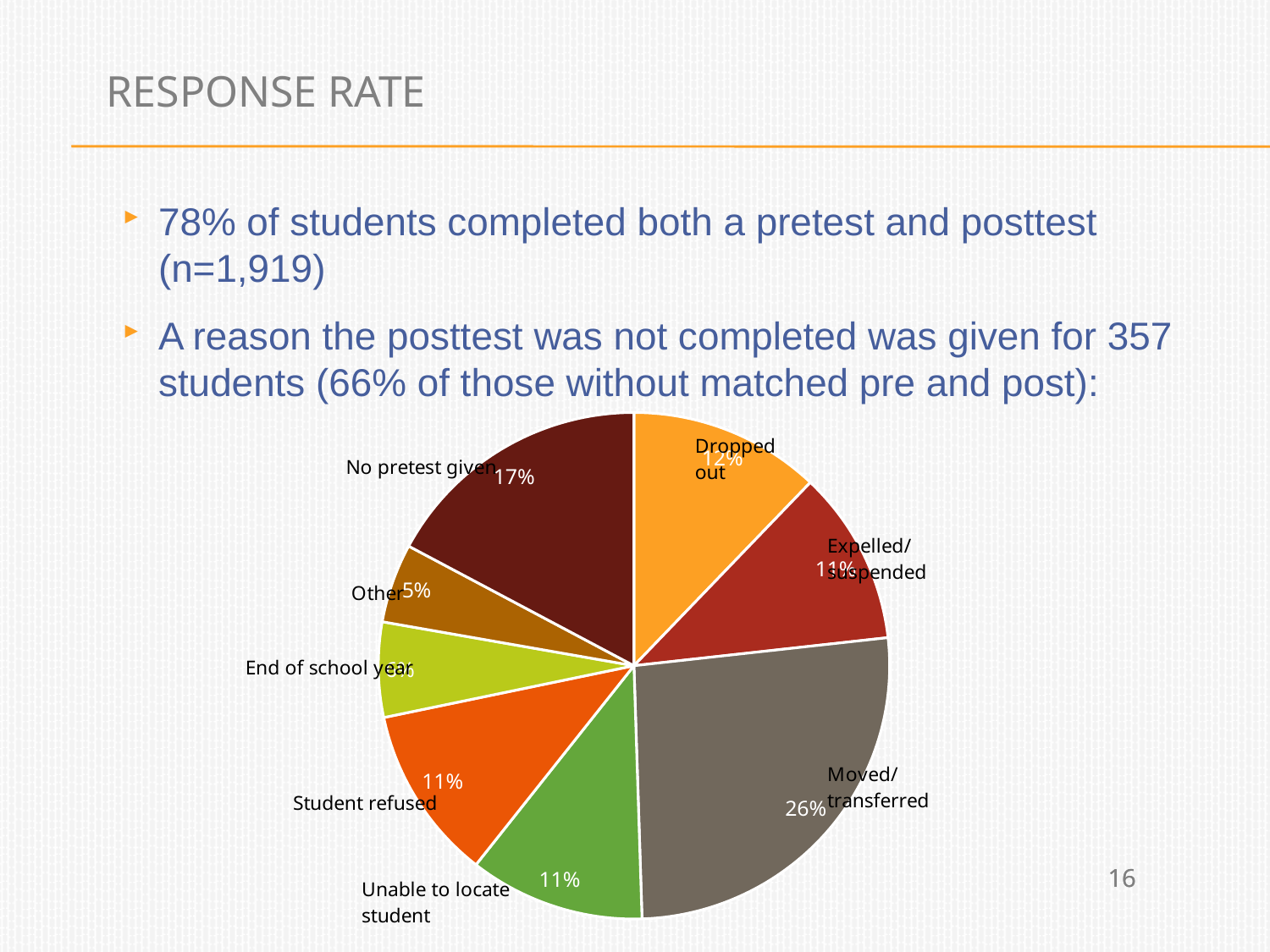
What share of the pie is Student refused? 11% What share of the pie is Unable to locate student? 11% What share of the pie is No pretest given? 17% Which reason has the largest slice of the pie? Moved/transferred What kind of chart is shown on the slide? pie chart Which slice is larger, No pretest given or Dropped out? No pretest given How many slices does the pie chart have? 8 What share of the pie is Other? 5% How many percentage points larger is Moved/transferred than No pretest given? 9 What share of the pie is Dropped out? 12% What share of the pie is Moved/transferred? 26% Which reason has the smallest slice of the pie? Other